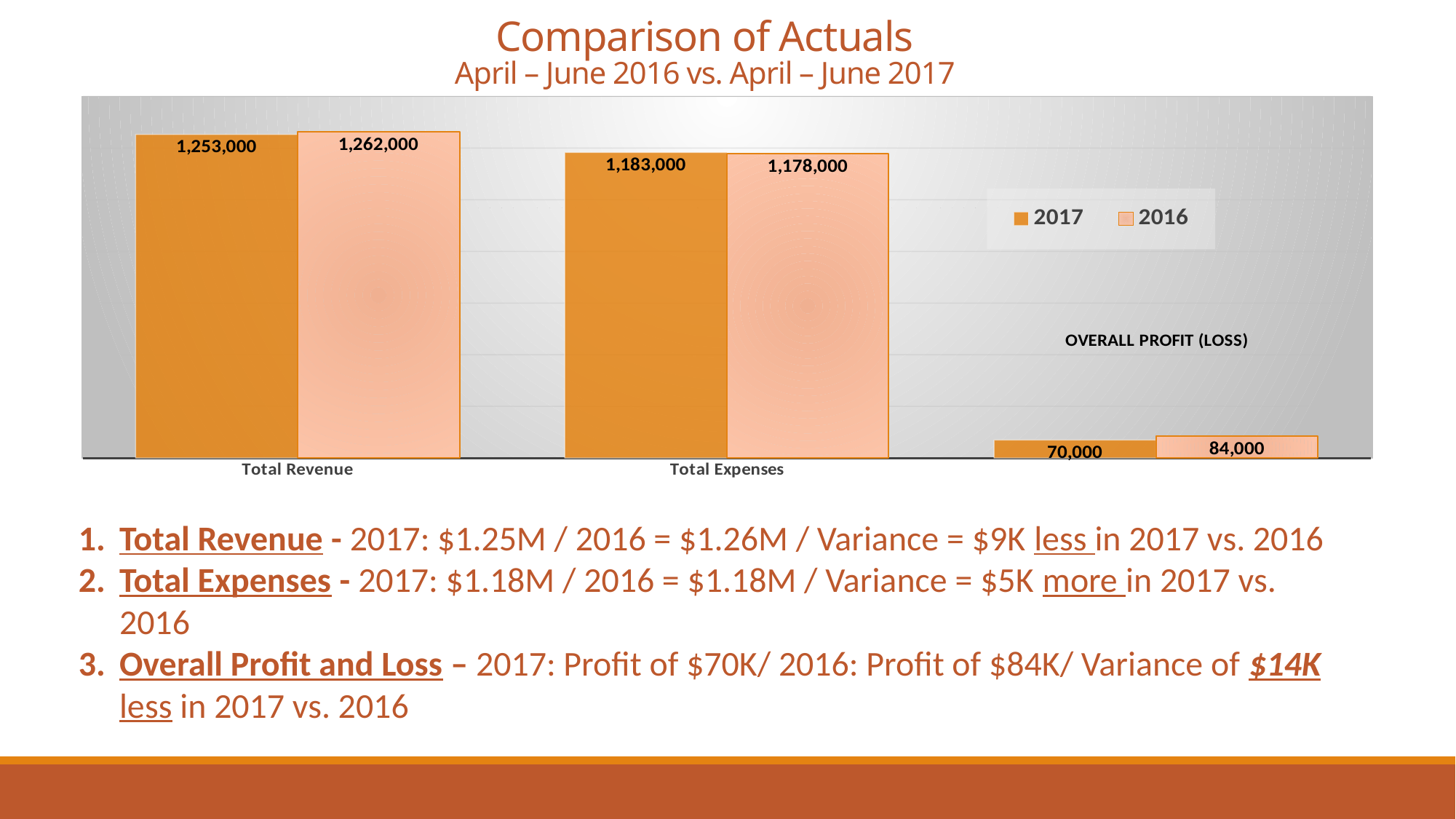
How many series does the legend list? 2 What is the difference between the 2016 and 2017 values for Overall Profit (Loss)? 14,000 What is the 2017 value for Total Revenue? 1,253,000 What is the 2016 value for Overall Profit (Loss)? 84,000 What is the 2016 value for Total Revenue? 1,262,000 What kind of chart is shown on the slide? Bar chart What is the 2017 value for Total Expenses? 1,183,000 What is the difference between the 2017 and 2016 values for Total Expenses? 5,000 What is the 2017 value for Overall Profit (Loss)? 70,000 What is the 2016 value for Total Expenses? 1,178,000 Which category has the lowest values in the chart? Overall Profit (Loss) What is the difference between the 2016 and 2017 values for Total Revenue? 9,000